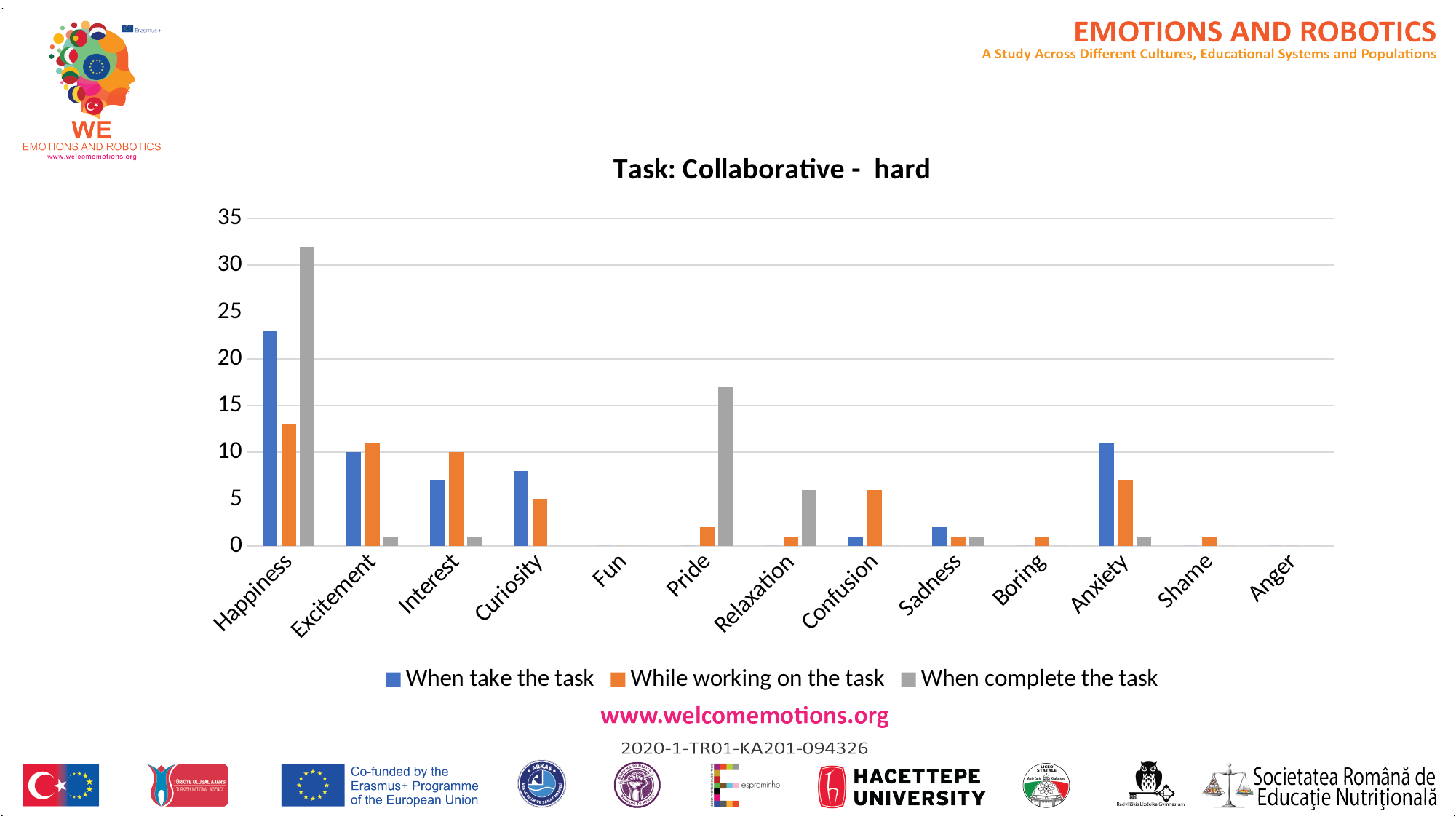
Which series is shown in grey in the legend? When complete the task Which emotion has the highest value for the 'When complete the task' series? Happiness What is the title of the chart? Task: Collaborative - hard What is the value for Curiosity in the 'While working on the task' series? 5 What kind of chart is shown on the slide? bar chart Is the value for Happiness in the 'When complete the task' series greater or less than 30? greater What is the value for Excitement in the 'When take the task' series? 10 Which emotion has the highest value for the 'When take the task' series? Happiness How many series does the legend list? 3 Is the value for Pride in the 'When complete the task' series greater or less than 15? greater How many emotion categories are shown on the x axis? 13 For Happiness, which is larger: the 'When take the task' value or the 'When complete the task' value? When complete the task